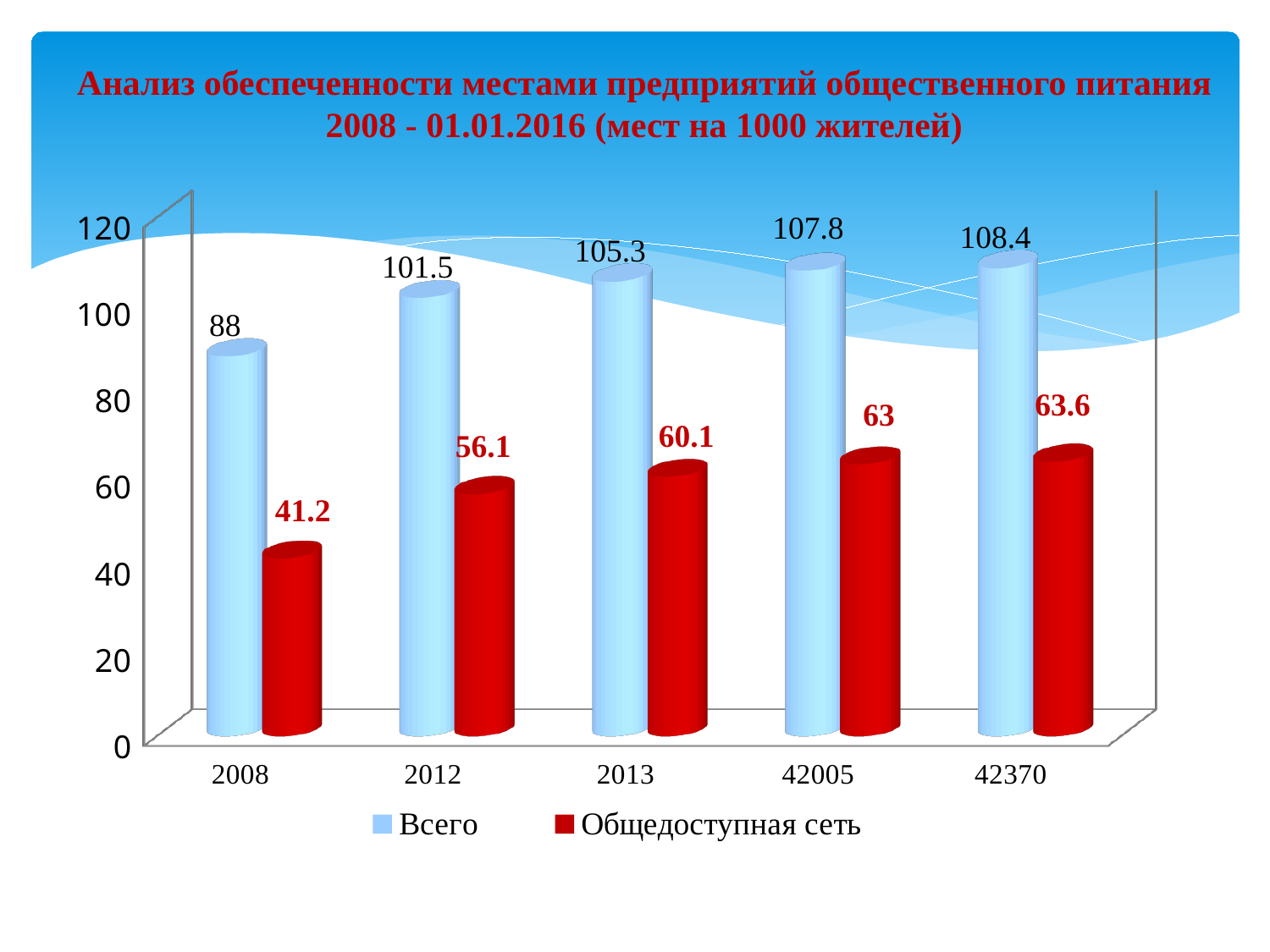
Which is larger: Общедоступная сеть for 2013 or for 2012? 2013 What is the value of Общедоступная сеть for 2012? 56.1 How many series does the legend list? 2 What is the value of Общедоступная сеть for 2013? 60.1 Do the Всего values rise or fall from left to right along the x axis? rise What is the difference between the Всего values for 2012 and 2008? 13.5 Which category has the highest value for Всего? 42370 What is the value of Всего for the category labelled 42370? 108.4 What is the value of Всего for 2008? 88 Which category has the lowest value for Общедоступная сеть? 2008 What is the difference between Всего and Общедоступная сеть for 2008? 46.8 How many categories are shown on the x axis? 5